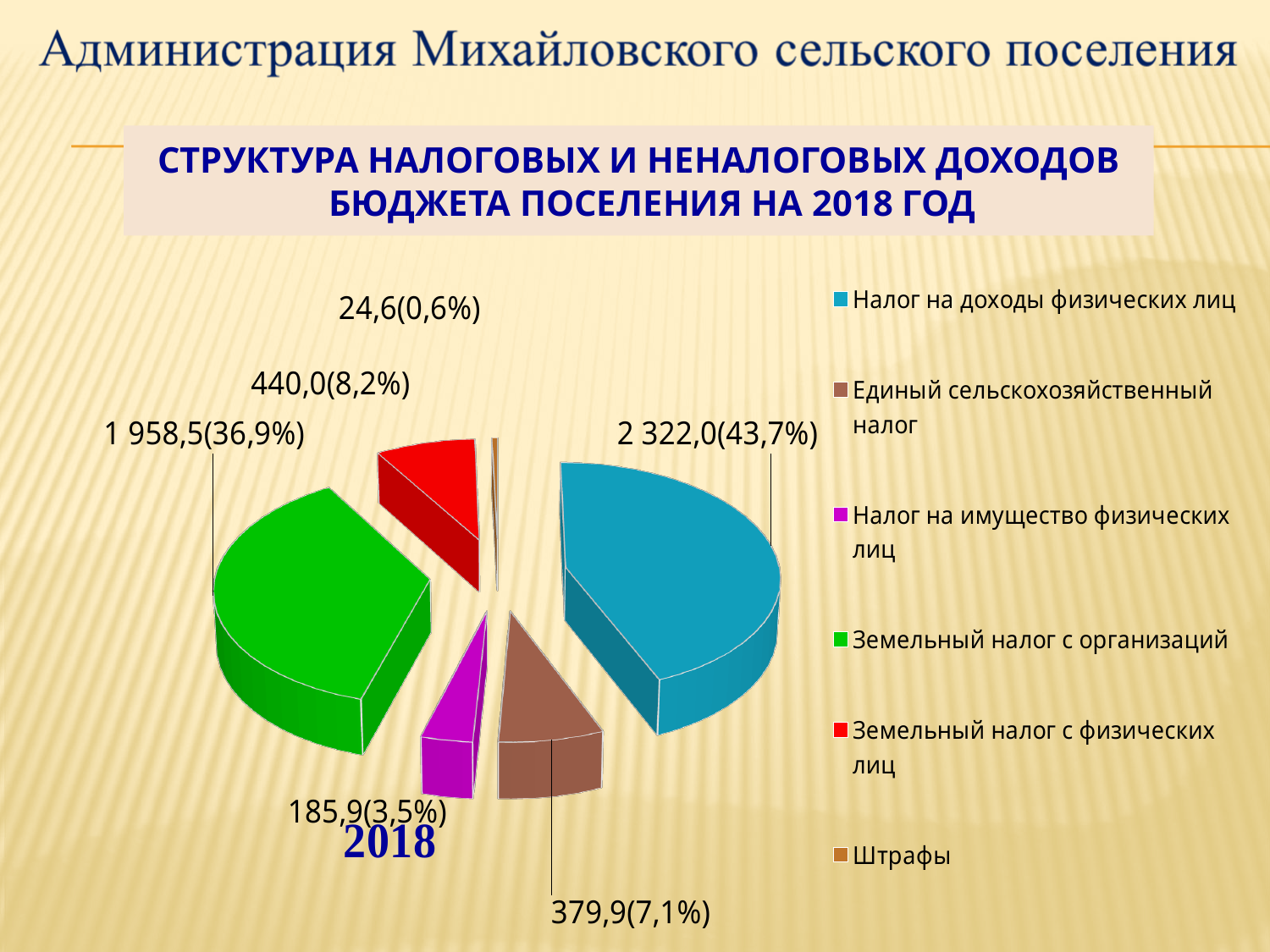
What value is shown for Единый сельскохозяйственный налог? 379,9(7,1%) What value is shown for Земельный налог с организаций? 1 958,5(36,9%) What value is shown for Налог на доходы физических лиц? 2 322,0(43,7%) What is the difference between the values for Налог на доходы физических лиц and Земельный налог с организаций? 363,5 What kind of chart is shown on the slide? pie chart What value is shown for Штрафы? 24,6(0,6%) How many slices does the pie chart have? 6 Which is larger: Единый сельскохозяйственный налог or Налог на имущество физических лиц? Единый сельскохозяйственный налог Which category has the smallest share of the pie? Штрафы Which category has the largest share of the pie? Налог на доходы физических лиц What share of the pie does Земельный налог с физических лиц represent? 8,2% What share of the pie does Налог на имущество физических лиц represent? 3,5%